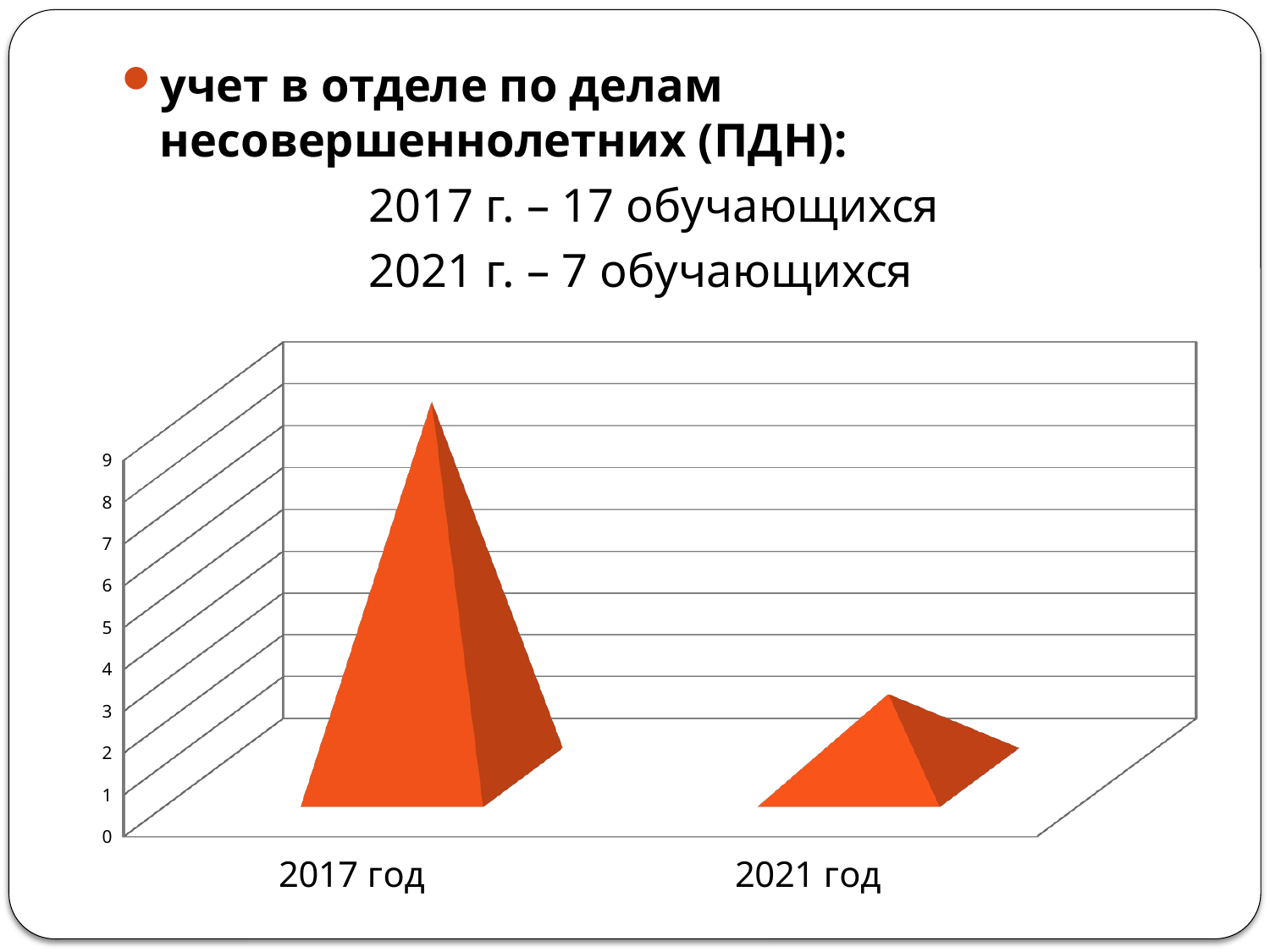
How many categories are plotted on the chart? 2 What is the highest tick label shown on the vertical axis of the chart? 9 Which category has the lowest value on the chart? 2021 год What are the two category labels on the horizontal axis of the chart? 2017 год and 2021 год Do the values rise or fall from 2017 год to 2021 год? fall What kind of chart is shown on the slide? bar chart Which is larger on the chart, the value for 2017 год or the value for 2021 год? 2017 год Which category has the highest value on the chart? 2017 год Is the value for 2021 год greater or less than 5? less Is the value for 2017 год greater or less than 5? greater